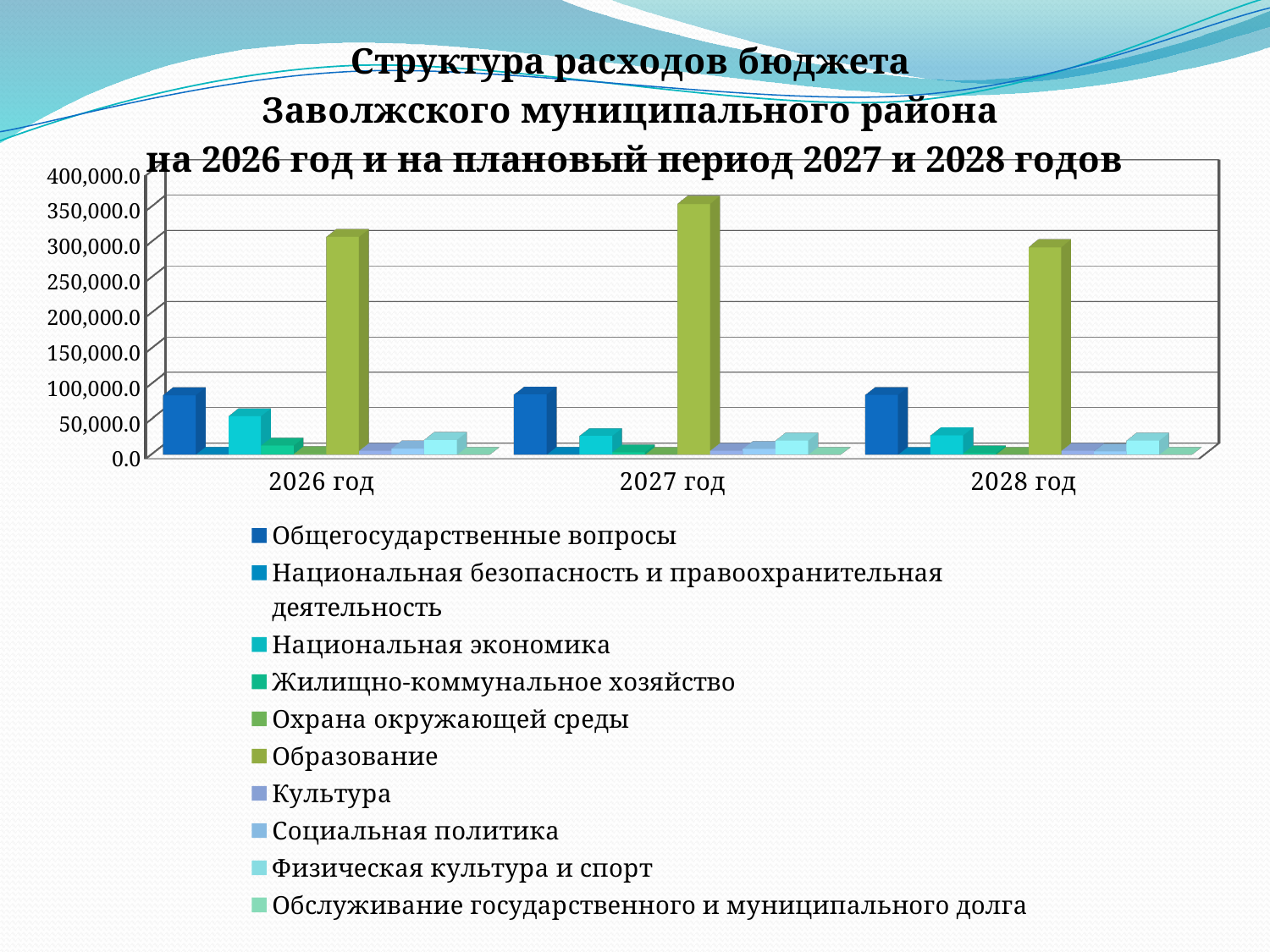
How many year categories are shown on the x axis? 3 Which series has the highest value in 2027 год? Образование Which is larger: the value for Образование in 2027 год or in 2026 год? 2027 год Is the value for Общегосударственные вопросы in 2028 год greater or less than 50,000.0? greater Is the value for Образование in 2026 год greater or less than 250,000.0? greater Is the value for Образование in 2027 год greater or less than 300,000.0? greater Which series has the highest value in 2026 год? Образование Which is larger: the value for Национальная экономика in 2026 год or in 2027 год? 2026 год How many series does the legend list? 10 What kind of chart is shown on the slide? bar chart Which year is listed first on the x axis? 2026 год